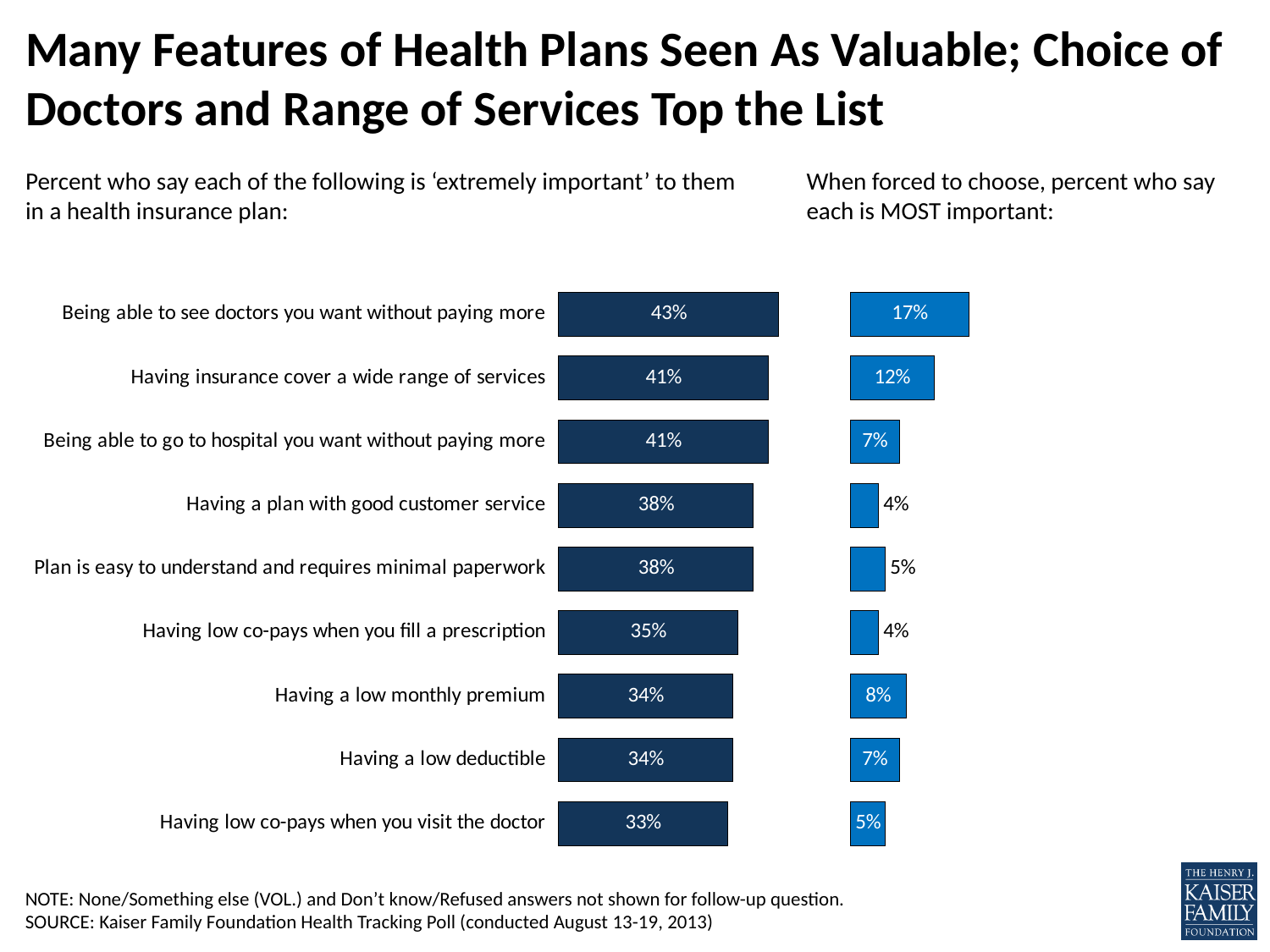
In the left chart, which is larger: the value for 'Having a plan with good customer service' or the value for 'Having low co-pays when you fill a prescription'? Having a plan with good customer service In the right chart, what is the value for 'Being able to go to hospital you want without paying more'? 7% In the left chart, what is the value for 'Plan is easy to understand and requires minimal paperwork'? 38% In the left chart, what is the difference between the values for 'Being able to see doctors you want without paying more' and 'Having low co-pays when you visit the doctor'? 10% What type of chart is used on this slide? Bar chart In the right chart, which feature has the highest percentage saying it is MOST important? Being able to see doctors you want without paying more How many features (categories) are listed in the left chart? 9 In the right chart, which is larger: the value for 'Having a low monthly premium' or the value for 'Having a plan with good customer service'? Having a low monthly premium In the left chart, which feature has the lowest percentage saying it is 'extremely important'? Having low co-pays when you visit the doctor In the right chart (percent who say each is MOST important), what is the value for 'Having a low monthly premium'? 8% In the left chart (percent who say each is 'extremely important'), what is the value for 'Being able to see doctors you want without paying more'? 43% In the right chart, what is the difference between the values for 'Being able to see doctors you want without paying more' and 'Having insurance cover a wide range of services'? 5%